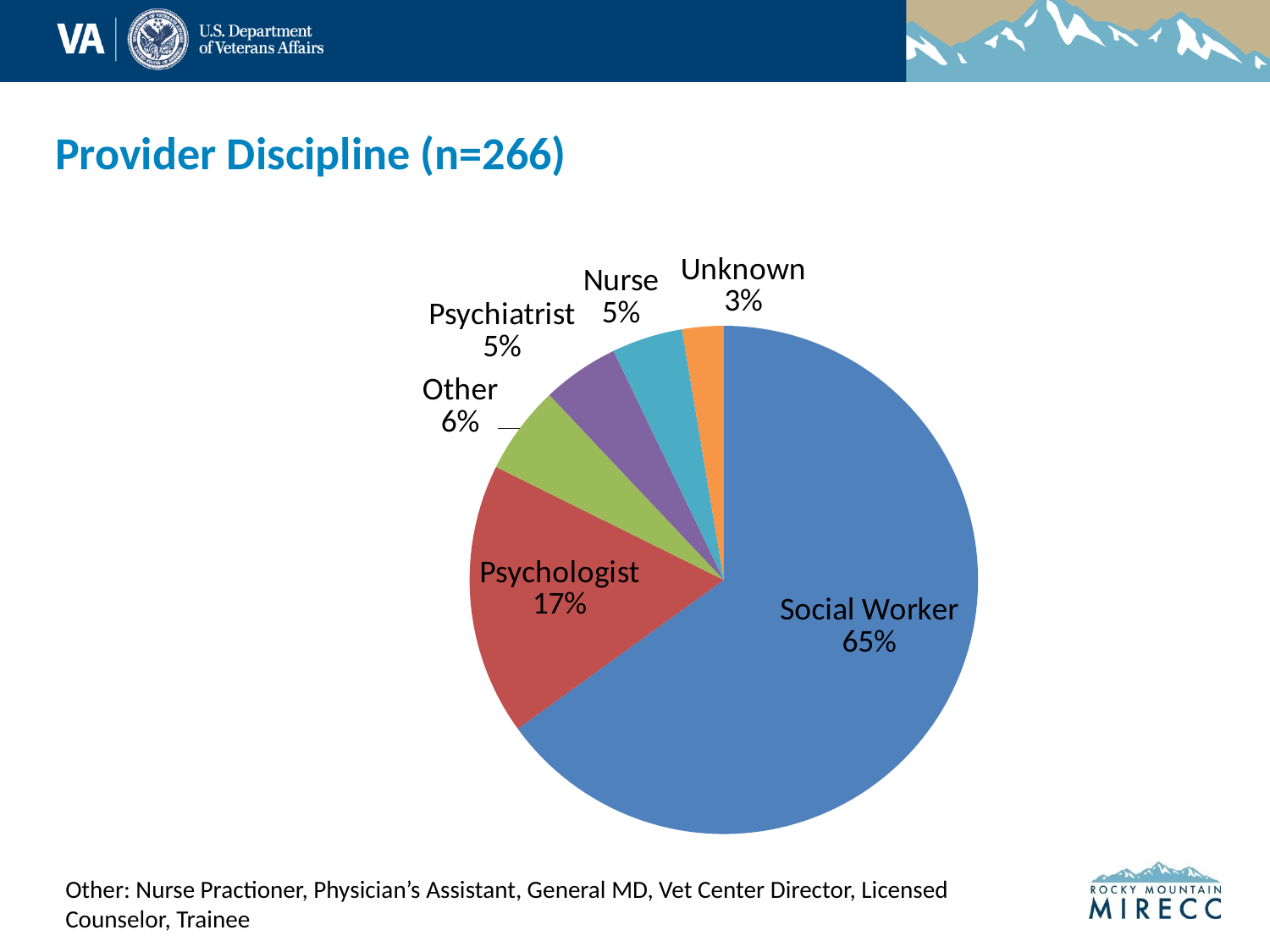
What kind of chart is shown on the slide? Pie chart What is the title of the chart? Provider Discipline (n=266) What is the value for Psychologist? 17% Which category has the smallest slice? Unknown Which category has the largest slice? Social Worker Which is larger, Other or Unknown? Other How many categories are shown in the pie chart? 6 What is the combined share of Psychiatrist and Nurse? 10% What is the value for Unknown? 3% What is the difference between the Social Worker and Psychologist shares? 48% What share of the pie does Social Worker represent? 65% What is the value for Other? 6%